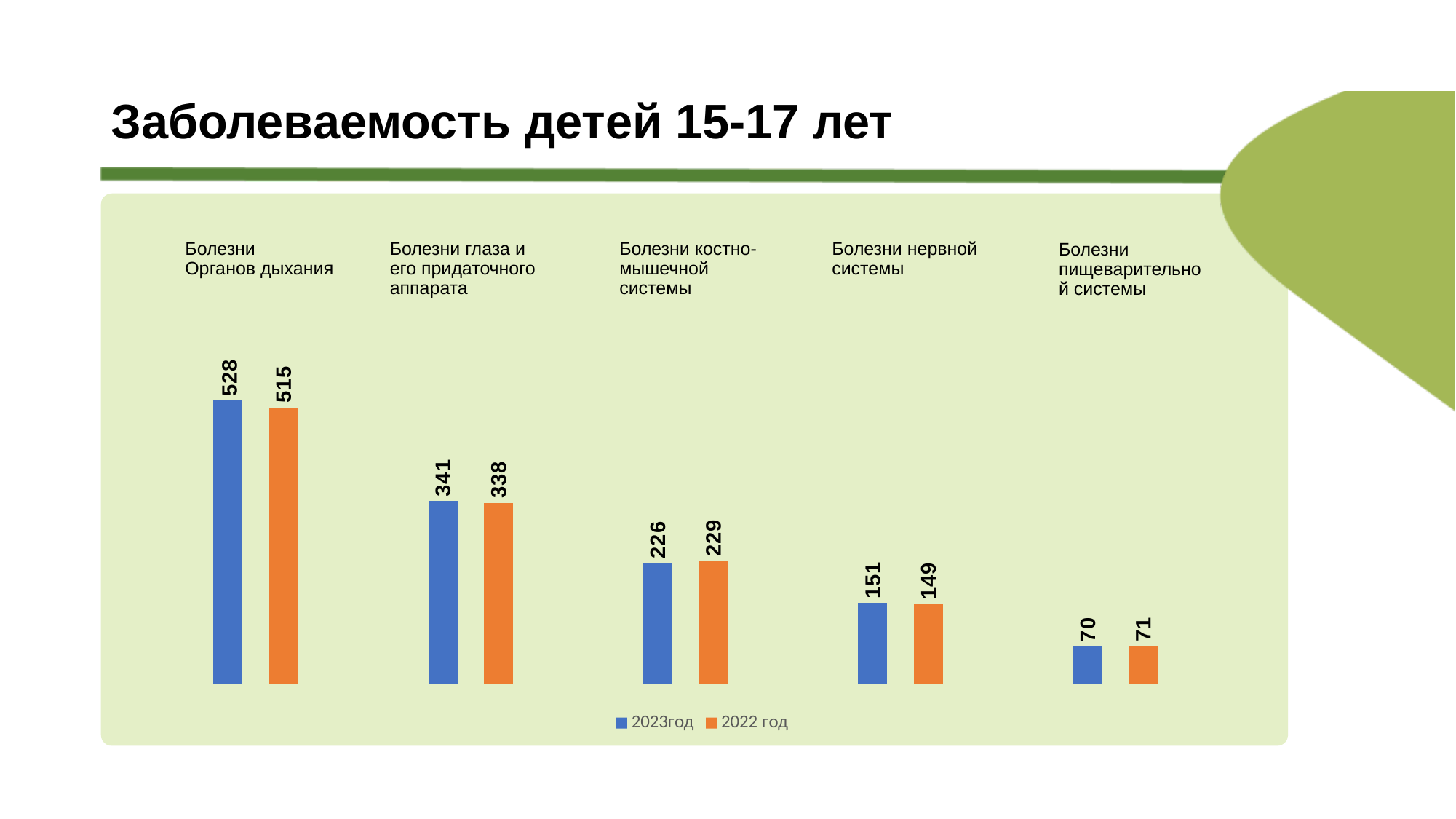
What is the value for Болезни нервной системы in 2022 год? 149 What is the value for Болезни органов дыхания in 2023год? 528 What is the difference between the 2022 год and 2023год values for Болезни костно-мышечной системы? 3 How many series does the legend list? 2 For Болезни глаза и его придаточного аппарата, which year has the larger value, 2023год or 2022 год? 2023год How many disease categories are shown in the chart? 5 What is the value for Болезни пищеварительной системы in 2023год? 70 Which category has the highest value in 2023год? Болезни органов дыхания What kind of chart is shown on the slide? Bar chart What is the difference between the 2023год and 2022 год values for Болезни органов дыхания? 13 For Болезни пищеварительной системы, which year has the larger value, 2023год or 2022 год? 2022 год Which category has the lowest value in 2022 год? Болезни пищеварительной системы